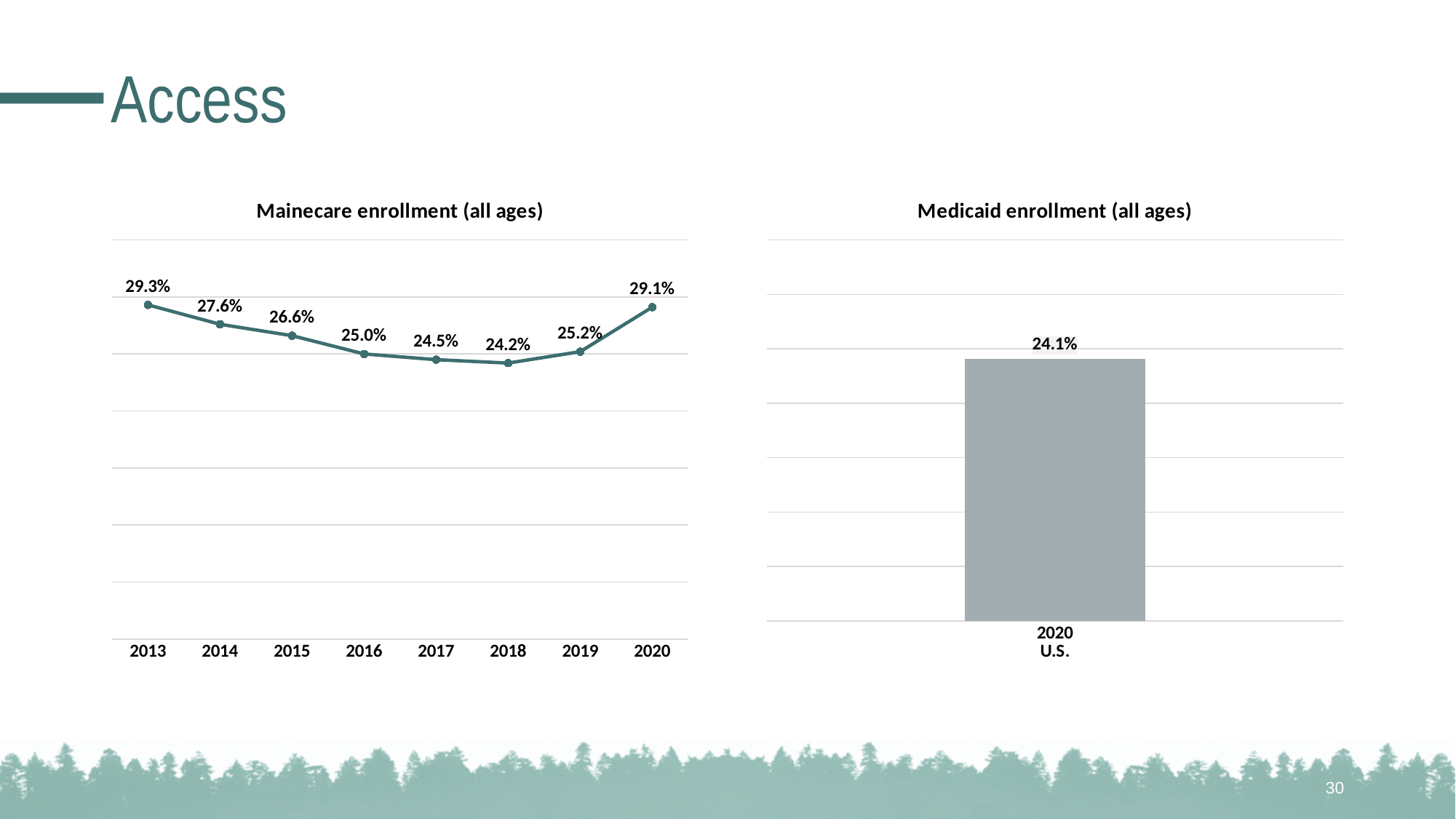
How many years are plotted in the 'Mainecare enrollment (all ages)' chart? 8 In the 'Medicaid enrollment (all ages)' chart, what is the value for 2020 U.S.? 24.1% In the 'Mainecare enrollment (all ages)' chart, what is the value for 2013? 29.3% In the 'Mainecare enrollment (all ages)' chart, do the values rise or fall from 2013 to 2018? Fall In the 'Mainecare enrollment (all ages)' chart, which year has the highest value? 2013 In the 'Mainecare enrollment (all ages)' chart, what is the difference between the 2013 value and the 2018 value? 5.1% What kind of chart is the 'Medicaid enrollment (all ages)' chart? Bar chart In the 'Mainecare enrollment (all ages)' chart, which is larger, the value for 2014 or the value for 2019? 2014 In the 'Mainecare enrollment (all ages)' chart, what is the value for 2020? 29.1% What kind of chart is the 'Mainecare enrollment (all ages)' chart? Line chart In the 'Mainecare enrollment (all ages)' chart, what is the value for 2018? 24.2% In the 'Mainecare enrollment (all ages)' chart, which year has the lowest value? 2018